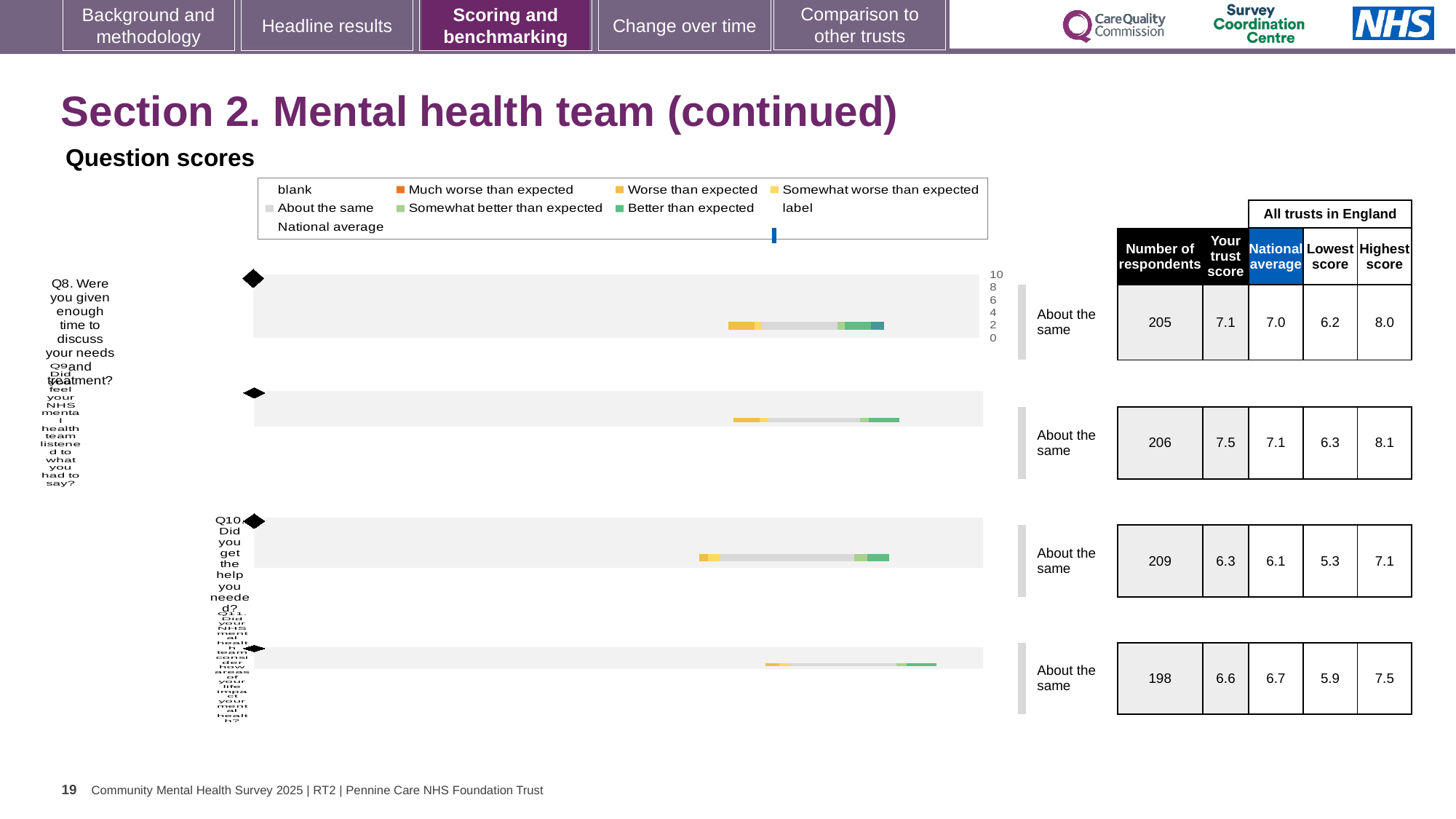
What is the 'Your trust score' for Q8 (Were you given enough time to discuss your needs and treatment?)? 7.1 Which question has the lowest 'Your trust score' on this slide? Q10 What kind of chart is used to show the question scores on this slide? bar chart Which question has the highest 'Your trust score' on this slide? Q9 What is the highest score across all trusts in England for Q11? 7.5 How many respondents answered Q10 (Did you get the help you needed?)? 209 What is the heading of the section of the table covering National average, Lowest score and Highest score? All trusts in England What is the difference between the trust score and the national average for Q9? 0.4 What benchmark category is shown next to each of the four question charts? About the same How many questions (Q8 to Q11) have a chart row on this slide? 4 For Q11, is the trust score or the national average higher? National average What is the national average score for Q9 (Did you feel your NHS mental health team listened to what you had to say?)? 7.1